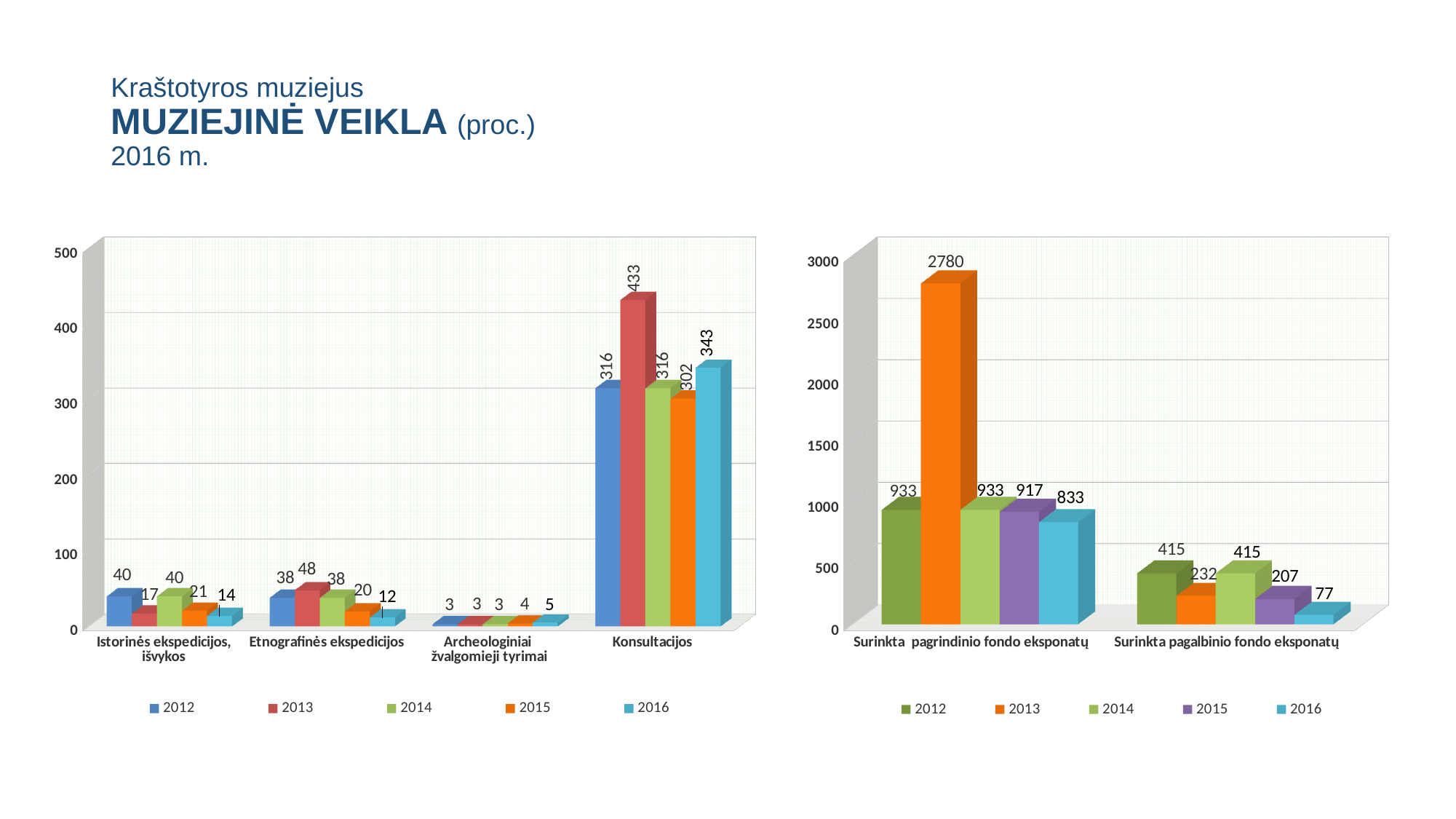
In the right chart, which is larger: the 2013 value or the 2015 value for Surinkta pagalbinio fondo eksponatų? 2013 In the left chart, what is the difference between the 2013 and 2015 values for Konsultacijos? 131 In the left chart, what is the value for 2013 in the Konsultacijos category? 433 In the left chart, what is the value for 2016 in the Etnografinės ekspedicijos category? 12 In the right chart, what is the difference between the 2012 and 2016 values for Surinkta pagrindinio fondo eksponatų? 100 In the left chart, how many categories are shown on the x axis? 4 In the right chart, which year has the lowest value in the Surinkta pagalbinio fondo eksponatų category? 2016 In the right chart, what is the value for 2013 in the Surinkta pagrindinio fondo eksponatų category? 2780 What type of chart is the right chart? Bar chart In the left chart, is the 2016 value for Konsultacijos greater or less than 300? greater How many series does the legend of the right chart list? 5 In the left chart, which year has the highest value in the Konsultacijos category? 2013